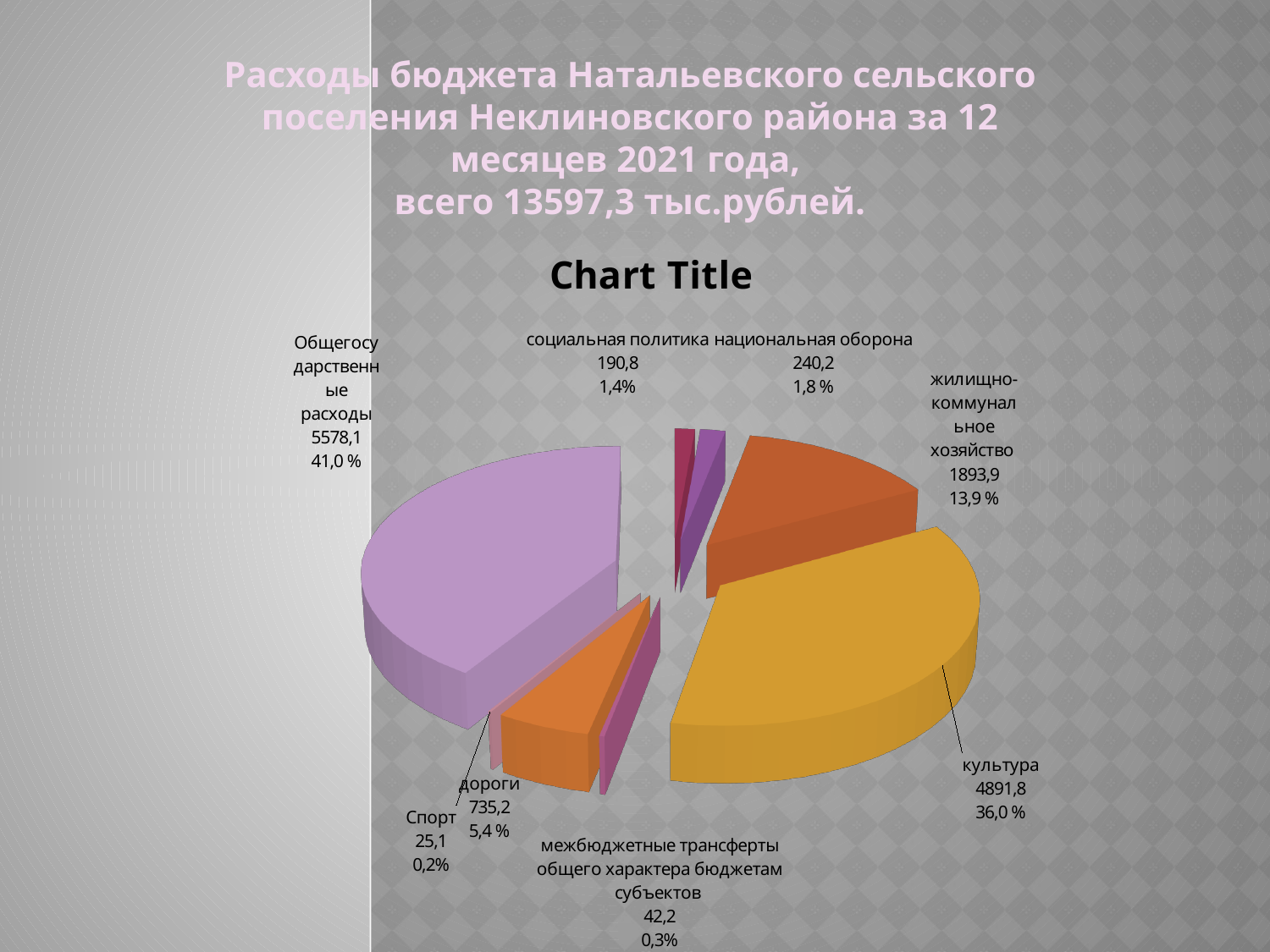
What share of the pie does социальная политика represent? 1,4% What is the value for дороги? 735,2 Which category has the smallest slice of the pie? Спорт What is the difference between the values for Общегосударственные расходы and культура? 686,3 What is the value for межбюджетные трансферты общего характера бюджетам субъектов? 42,2 Which is larger, the value for национальная оборона or the value for социальная политика? национальная оборона What kind of chart is shown on the slide? pie chart What is the value for культура? 4891,8 How many categories (slices) does the pie chart show? 8 Which category has the largest slice of the pie? Общегосударственные расходы What share of the pie does жилищно-коммунальное хозяйство represent? 13,9 % What is the title printed directly above the pie chart? Chart Title